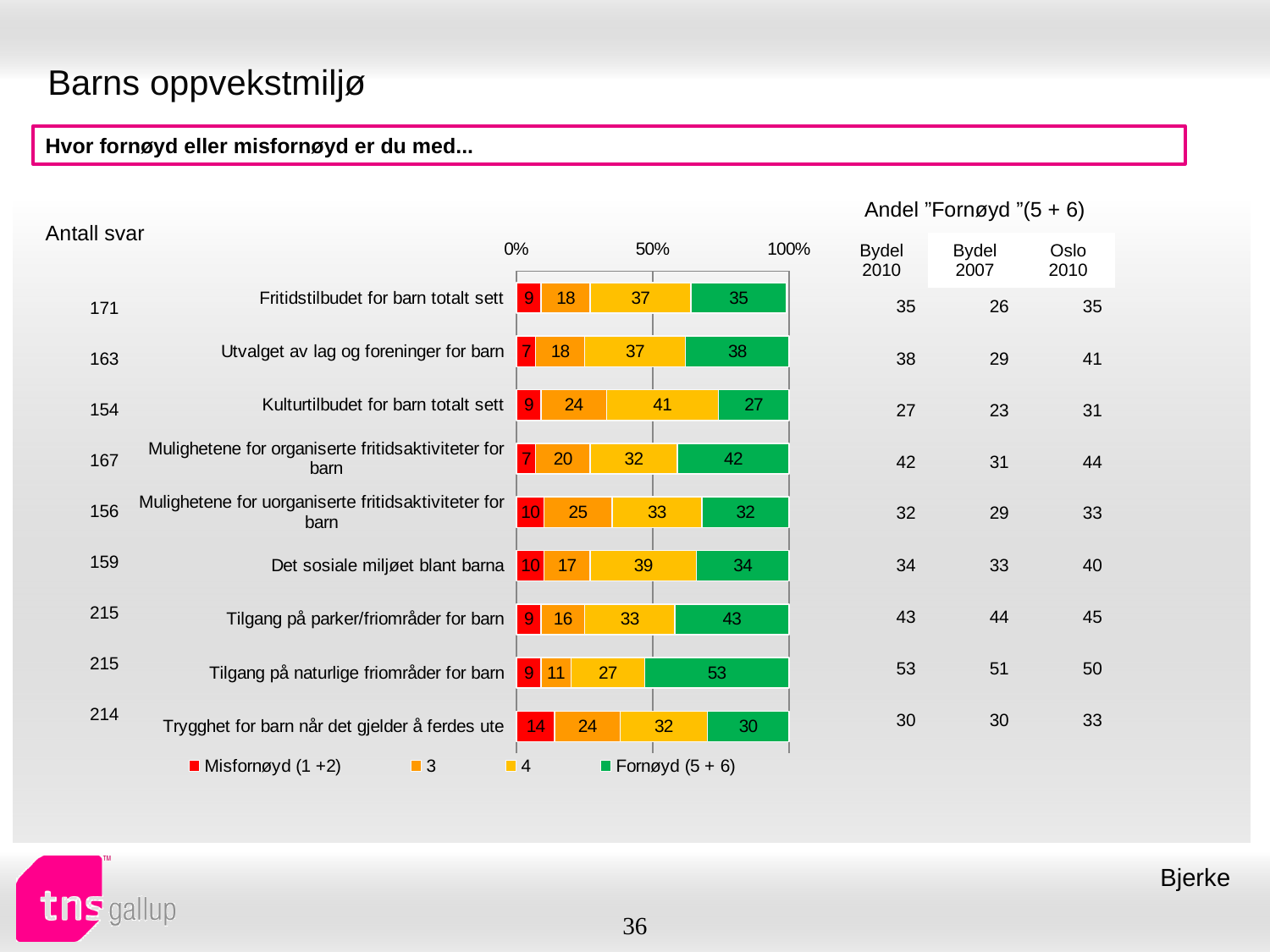
What is the 'Misfornøyd (1 +2)' value for 'Trygghet for barn når det gjelder å ferdes ute'? 14 Which category has the highest 'Fornøyd (5 + 6)' value? Tilgang på naturlige friområder for barn Which category has the lowest 'Fornøyd (5 + 6)' value? Kulturtilbudet for barn totalt sett Which colour represents the 'Fornøyd (5 + 6)' series in the chart? Green What is the 'Fornøyd (5 + 6)' value for 'Tilgang på naturlige friområder for barn'? 53 What is the difference between the 'Fornøyd (5 + 6)' values for 'Tilgang på naturlige friområder for barn' and 'Tilgang på parker/friområder for barn'? 10 Which has a larger 'Fornøyd (5 + 6)' value: 'Mulighetene for organiserte fritidsaktiviteter for barn' or 'Det sosiale miljøet blant barna'? Mulighetene for organiserte fritidsaktiviteter for barn What type of chart is shown on the slide? Stacked bar chart How many series does the chart legend list? 4 What is the value of series '4' for 'Kulturtilbudet for barn totalt sett'? 41 How many categories (statements) are plotted in the chart? 9 What is the total of the stacked bar for 'Trygghet for barn når det gjelder å ferdes ute'? 100